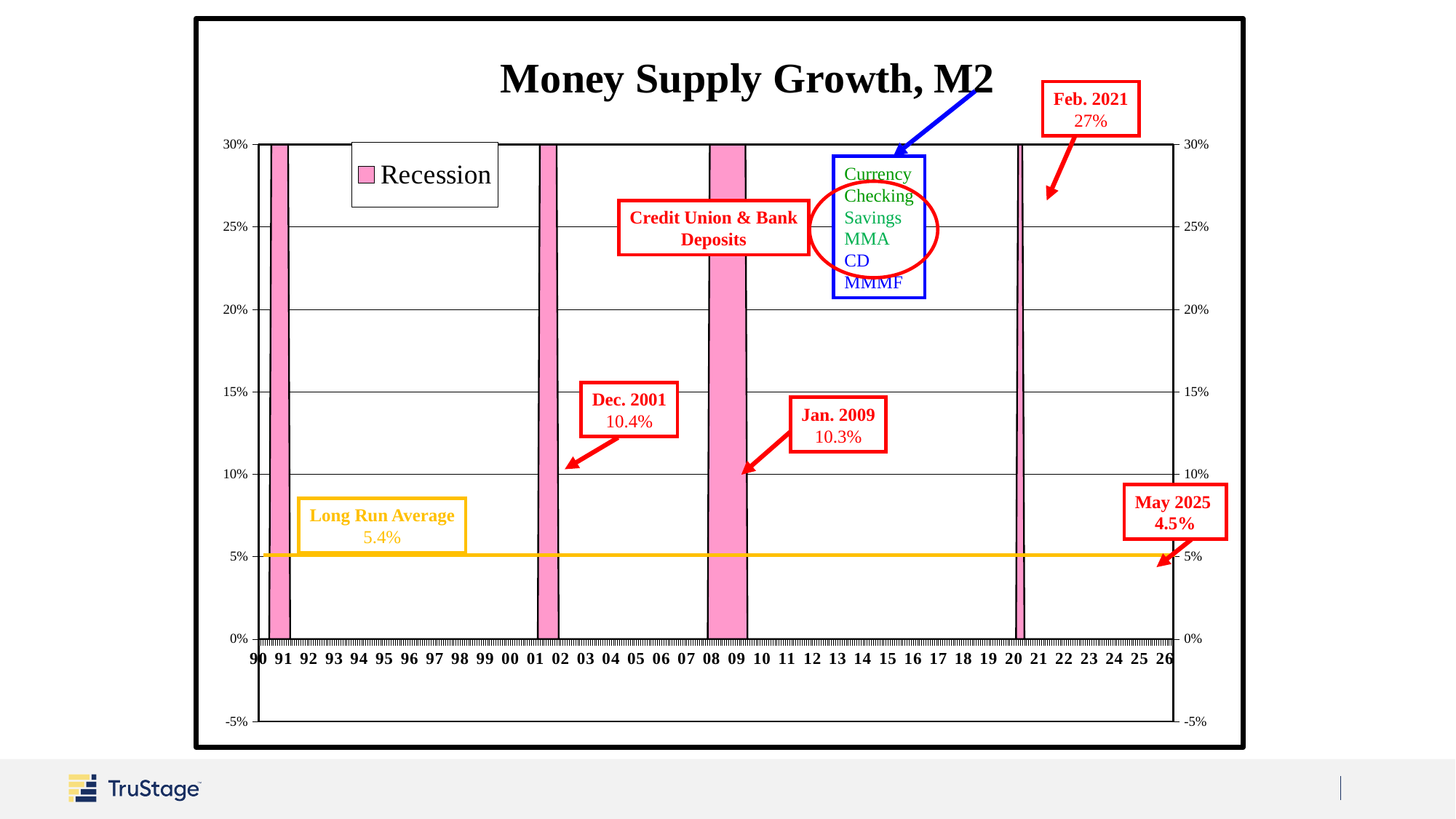
How many recession periods are shaded on the chart? 4 What is the M2 money supply growth value annotated for Feb. 2021? 27% What is the title of the chart? Money Supply Growth, M2 Of the four dated annotations on the chart, which has the highest growth value? Feb. 2021 What is the Long Run Average value shown on the chart? 5.4% What is the M2 money supply growth value annotated for Dec. 2001? 10.4% What is the M2 money supply growth value annotated for May 2025? 4.5% What does the pink shading in the chart's legend represent? Recession What is the M2 money supply growth value annotated for Jan. 2009? 10.3% Is the annotated May 2025 value larger or smaller than the Long Run Average? smaller What is the difference between the annotated Feb. 2021 value and the annotated May 2025 value? 22.5% Of the four dated annotations on the chart, which has the lowest growth value? May 2025